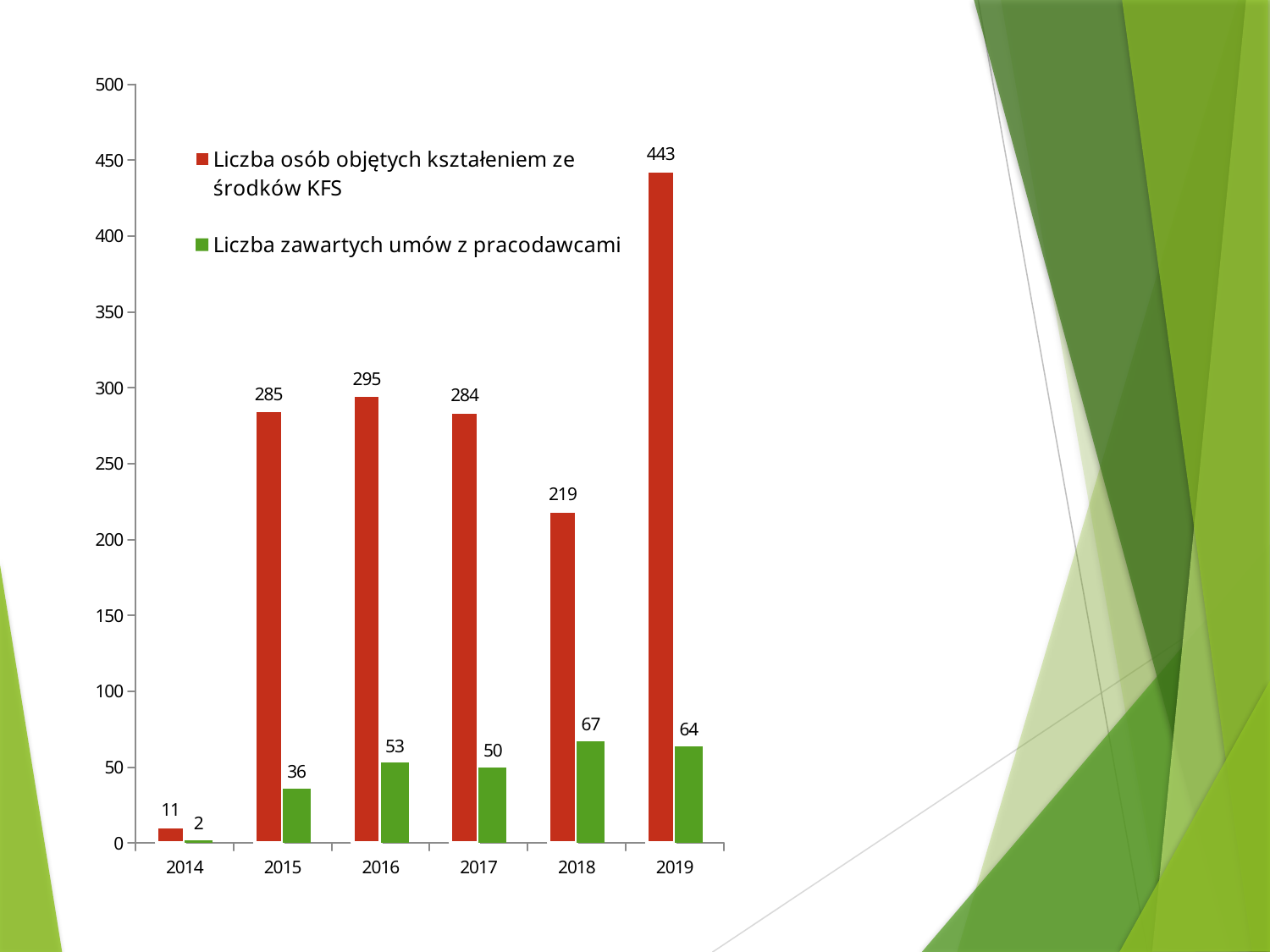
What is the value of 'Liczba osób objętych kształceniem ze środków KFS' for 2014? 11 Which is larger: 'Liczba zawartych umów z pracodawcami' in 2017 or in 2018? 2018 What is the value of 'Liczba osób objętych kształceniem ze środków KFS' for 2019? 443 Which year has the highest value for 'Liczba zawartych umów z pracodawcami'? 2018 How many series does the legend list? 2 How many years are shown on the x axis? 6 What is the difference between the 'Liczba osób objętych kształceniem ze środków KFS' values for 2019 and 2018? 224 Which colour represents 'Liczba zawartych umów z pracodawcami' in the chart? green What is the value of 'Liczba zawartych umów z pracodawcami' for 2016? 53 Which year has the lowest value for 'Liczba osób objętych kształceniem ze środków KFS'? 2014 What kind of chart is shown on the slide? bar chart Is the value for 'Liczba osób objętych kształceniem ze środków KFS' in 2018 greater or less than 250? less